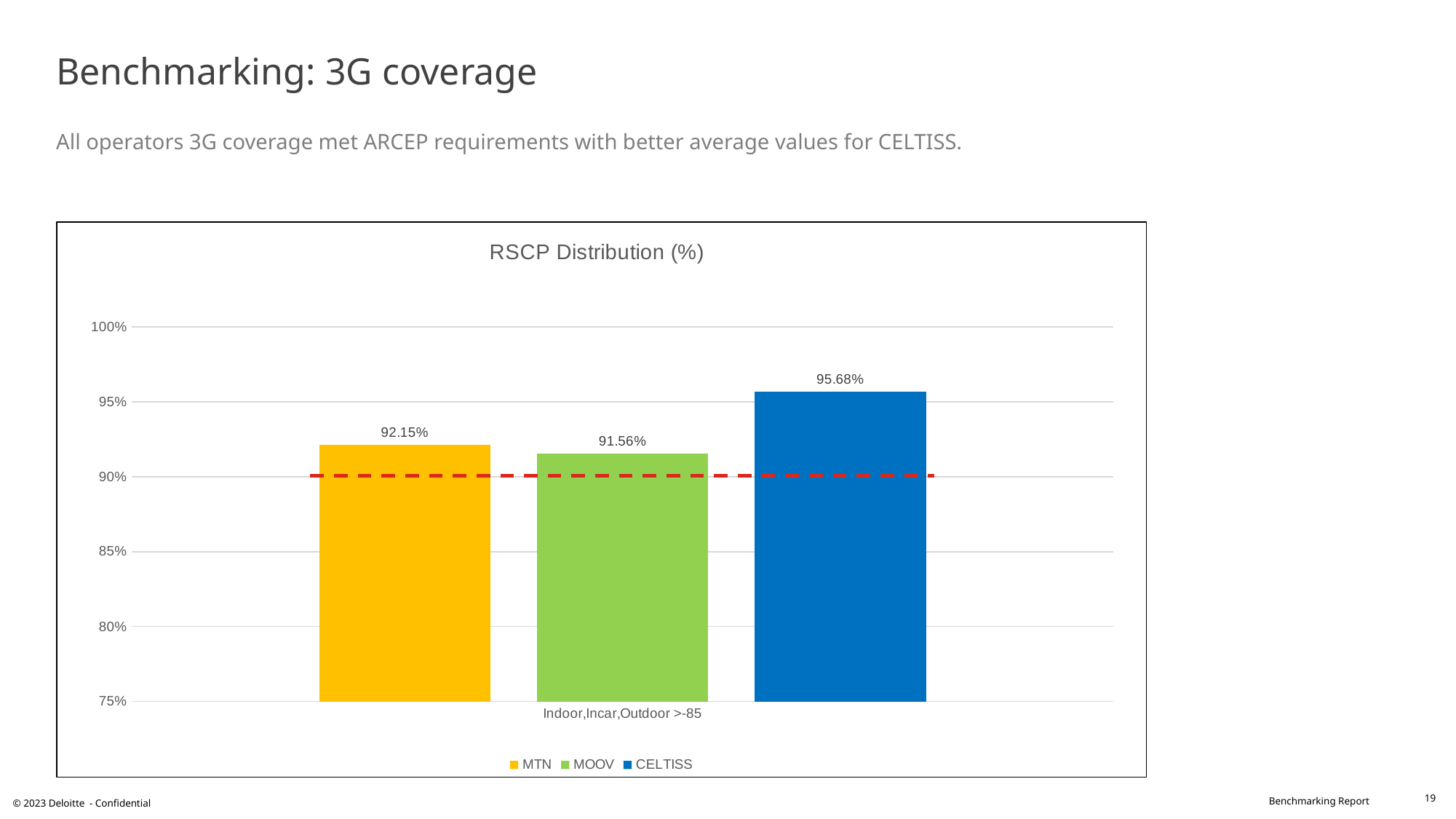
Which is larger, the value for CELTISS or the value for MOOV? CELTISS What is the RSCP distribution value for MTN? 92.15% Which operator has the lowest RSCP distribution value? MOOV Is the value for CELTISS greater or less than 95%? greater What is the RSCP distribution value for MOOV? 91.56% What kind of chart is shown on the slide? Bar chart What is the title of the chart? RSCP Distribution (%) Which operator has the highest RSCP distribution value? CELTISS What is the difference between the MTN and MOOV values? 0.59% What is the difference between the CELTISS and MTN values? 3.53% How many series does the legend list? 3 What is the RSCP distribution value for CELTISS? 95.68%